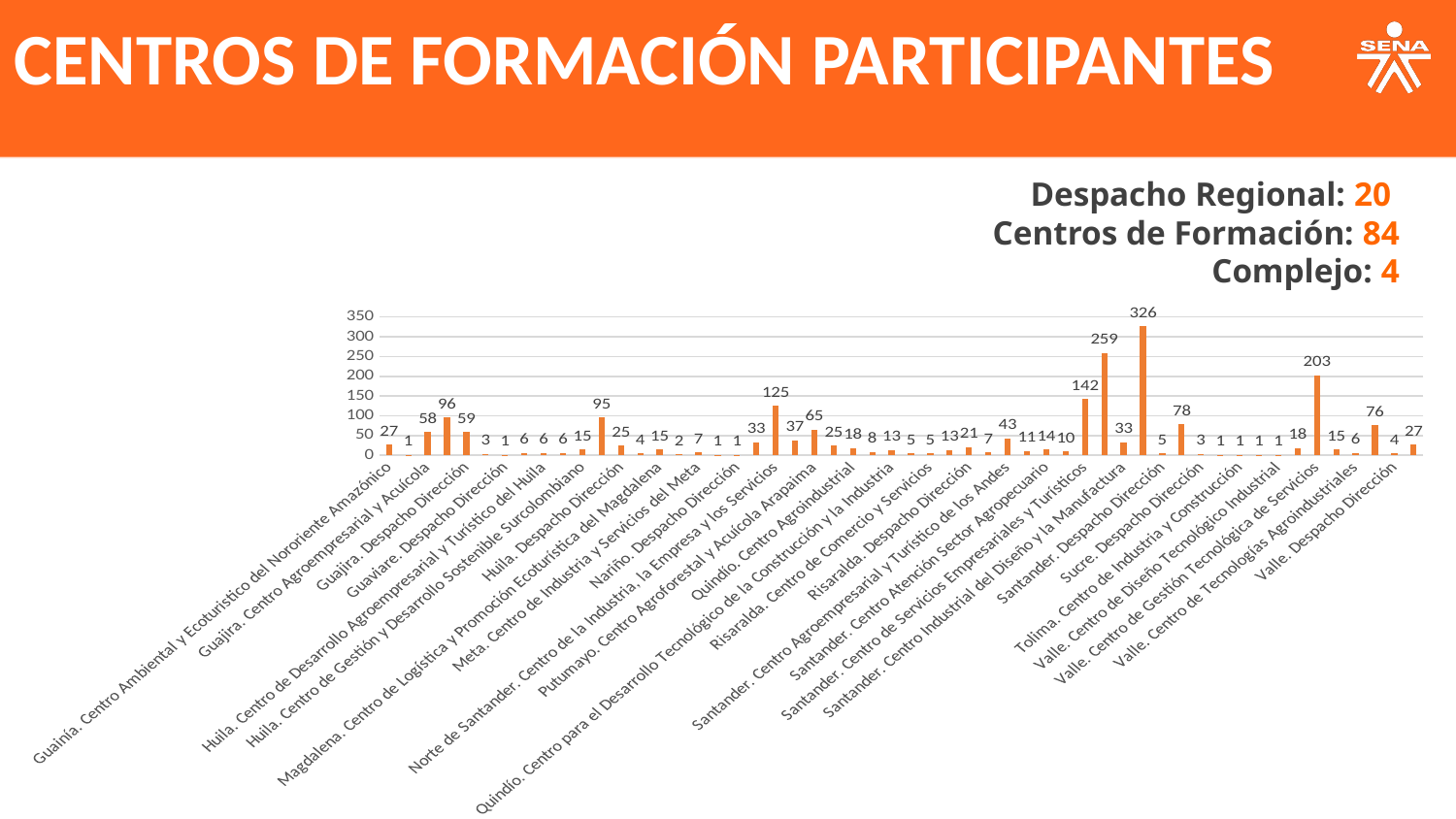
What is the highest value shown in the chart? 326 What is the value for Valle. Centro de Gestión Tecnológica de Servicios? 203 What is the value for Norte de Santander. Centro de la Industria, la Empresa y los Servicios? 125 What is the value for Putumayo. Centro Agroforestal y Acuícola Arapaima? 65 What is the lowest value shown in the chart? 1 What is the difference between the two highest values in the chart, 326 and 259? 67 What is the value for Guainía. Centro Ambiental y Ecoturístico del Nororiente Amazónico? 27 Which is larger: the value for Norte de Santander. Centro de la Industria, la Empresa y los Servicios or the value for Putumayo. Centro Agroforestal y Acuícola Arapaima? Norte de Santander. Centro de la Industria, la Empresa y los Servicios What is the difference between the value for Valle. Centro de Gestión Tecnológica de Servicios and the value for Santander. Centro de Servicios Empresariales y Turísticos? 61 What colour are the bars in the chart? Orange What is the value for Santander. Centro de Servicios Empresariales y Turísticos? 142 What kind of chart is shown on the slide? Bar chart